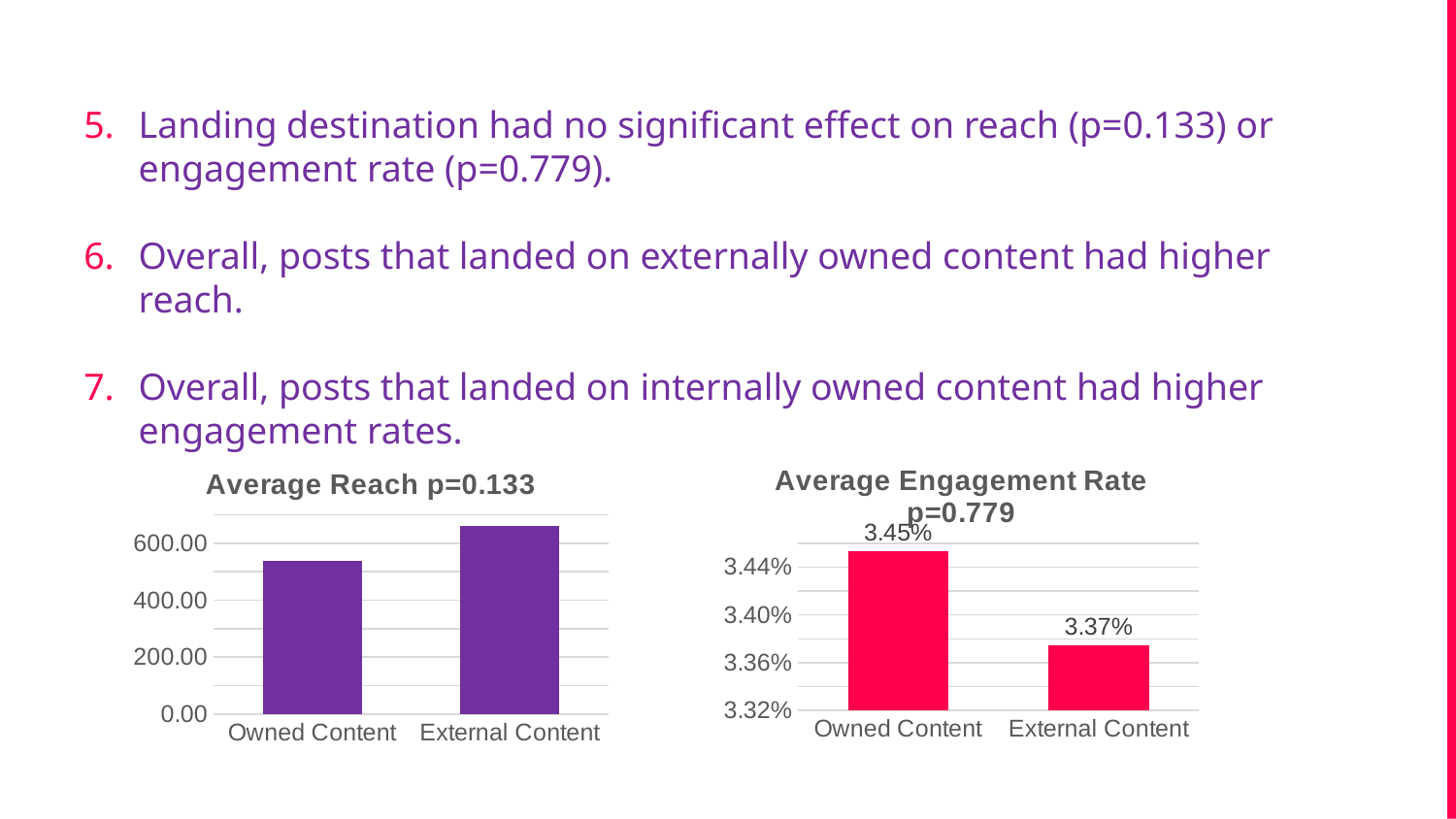
What colour are the bars in the "Average Engagement Rate p=0.779" chart? pink/red In the "Average Reach p=0.133" chart, is the value for Owned Content greater or less than 600.00? less In the "Average Reach p=0.133" chart, which category has the higher value? External Content In the "Average Engagement Rate p=0.779" chart, what is the value for External Content? 3.37% In the "Average Reach p=0.133" chart, is the value for External Content greater or less than 600.00? greater In the "Average Reach p=0.133" chart, is the value for Owned Content greater or less than 400.00? greater What kind of chart is the "Average Reach p=0.133" chart? bar chart In the "Average Engagement Rate p=0.779" chart, what is the value for Owned Content? 3.45% In the "Average Engagement Rate p=0.779" chart, which category has the lowest value? External Content In the "Average Engagement Rate p=0.779" chart, what is the difference between Owned Content and External Content? 0.08% How many categories are shown in the "Average Reach p=0.133" chart? 2